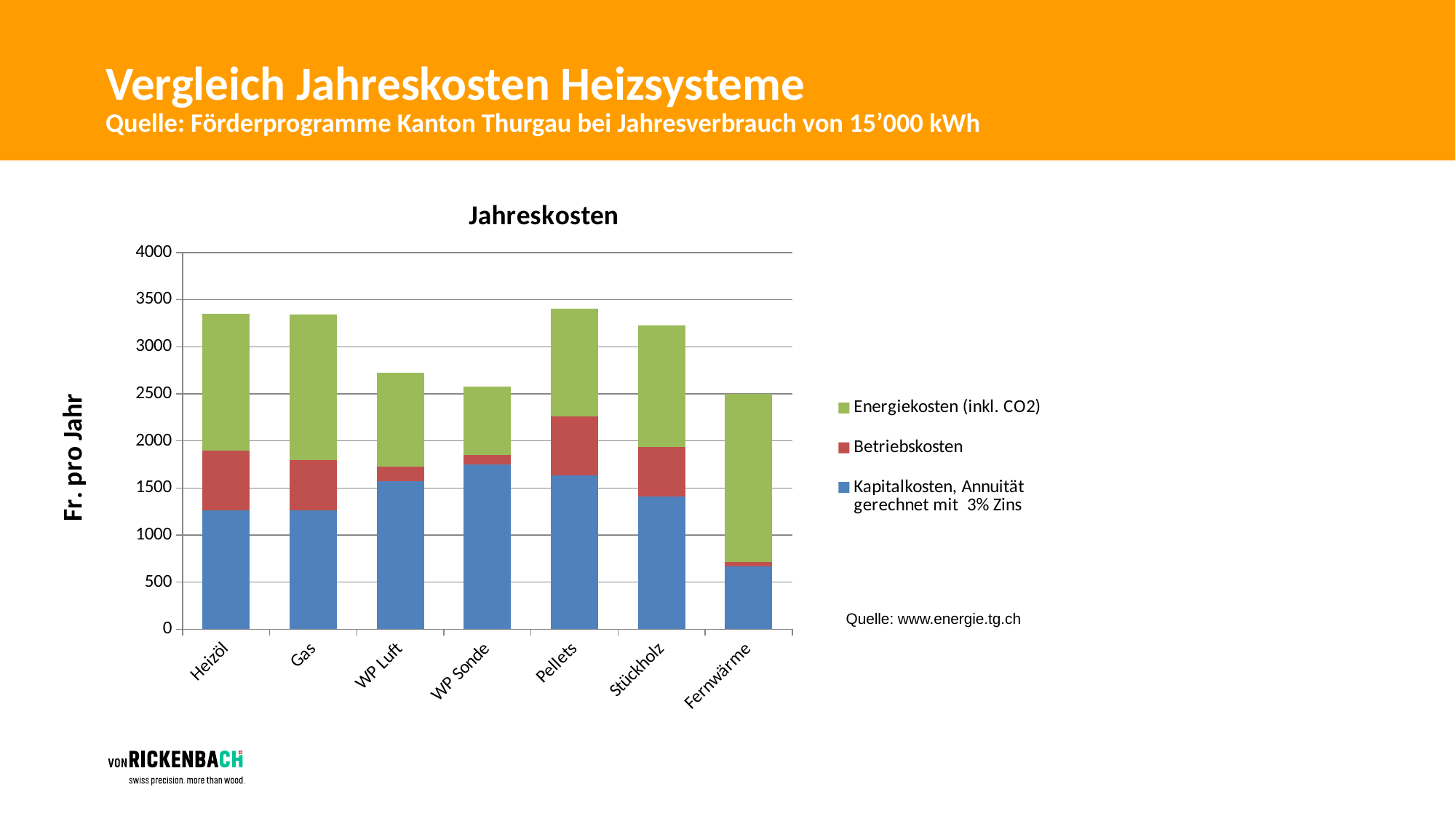
Which has the larger total annual cost, Heizöl or WP Sonde? Heizöl How many series does the legend list? 3 Is the total annual cost for WP Luft greater or less than 3000? less Is the Kapitalkosten value for Fernwärme greater or less than 1000? less What kind of chart is shown on the slide? Stacked bar chart What is the label on the vertical axis? Fr. pro Jahr Which heating system has the lowest Betriebskosten (red segment)? Fernwärme Which heating system has the lowest Kapitalkosten (blue segment)? Fernwärme Which heating system has the highest Betriebskosten (red segment)? Heizöl and Pellets (tied) How many heating systems (categories) are shown on the x axis? 7 What is the title of the chart? Jahreskosten Is the total annual cost for Heizöl greater or less than 3000? greater